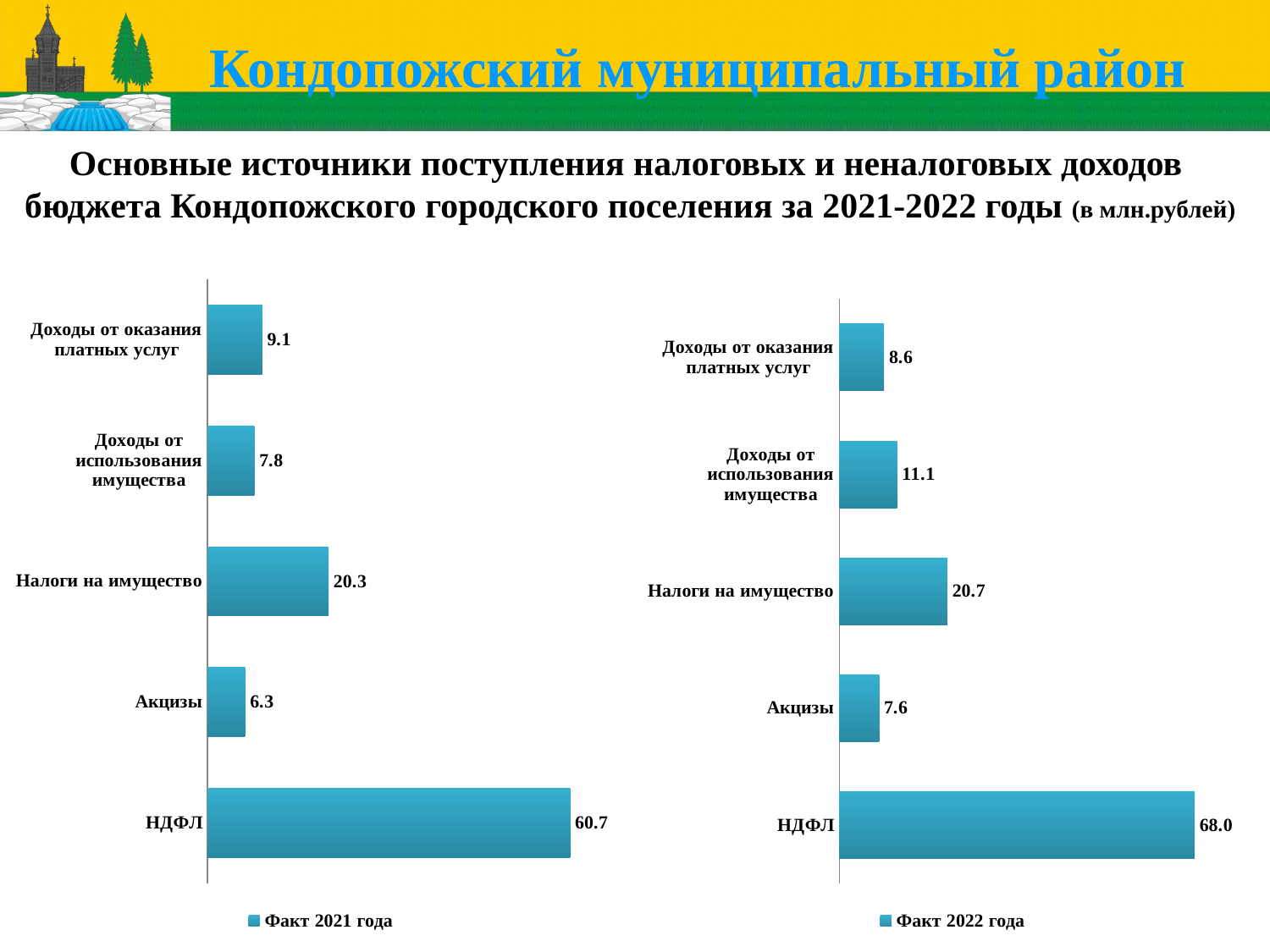
How many categories are shown in the right chart (Факт 2022 года)? 5 How many series does the legend of the left chart list? 1 In the left chart (Факт 2021 года), which is larger: Доходы от оказания платных услуг or Доходы от использования имущества? Доходы от оказания платных услуг What type of chart is the left chart (Факт 2021 года)? bar chart In the right chart (Факт 2022 года), which category has the highest value? НДФЛ In the right chart (Факт 2022 года), what is the difference between НДФЛ and Налоги на имущество? 47.3 In the right chart (Факт 2022 года), what is the value for Доходы от использования имущества? 11.1 In the left chart (Факт 2021 года), what is the value for Акцизы? 6.3 What is the legend entry of the right chart? Факт 2022 года In the right chart (Факт 2022 года), what is the value for Акцизы? 7.6 In the left chart (Факт 2021 года), what is the value for НДФЛ? 60.7 In the left chart (Факт 2021 года), which category has the lowest value? Акцизы